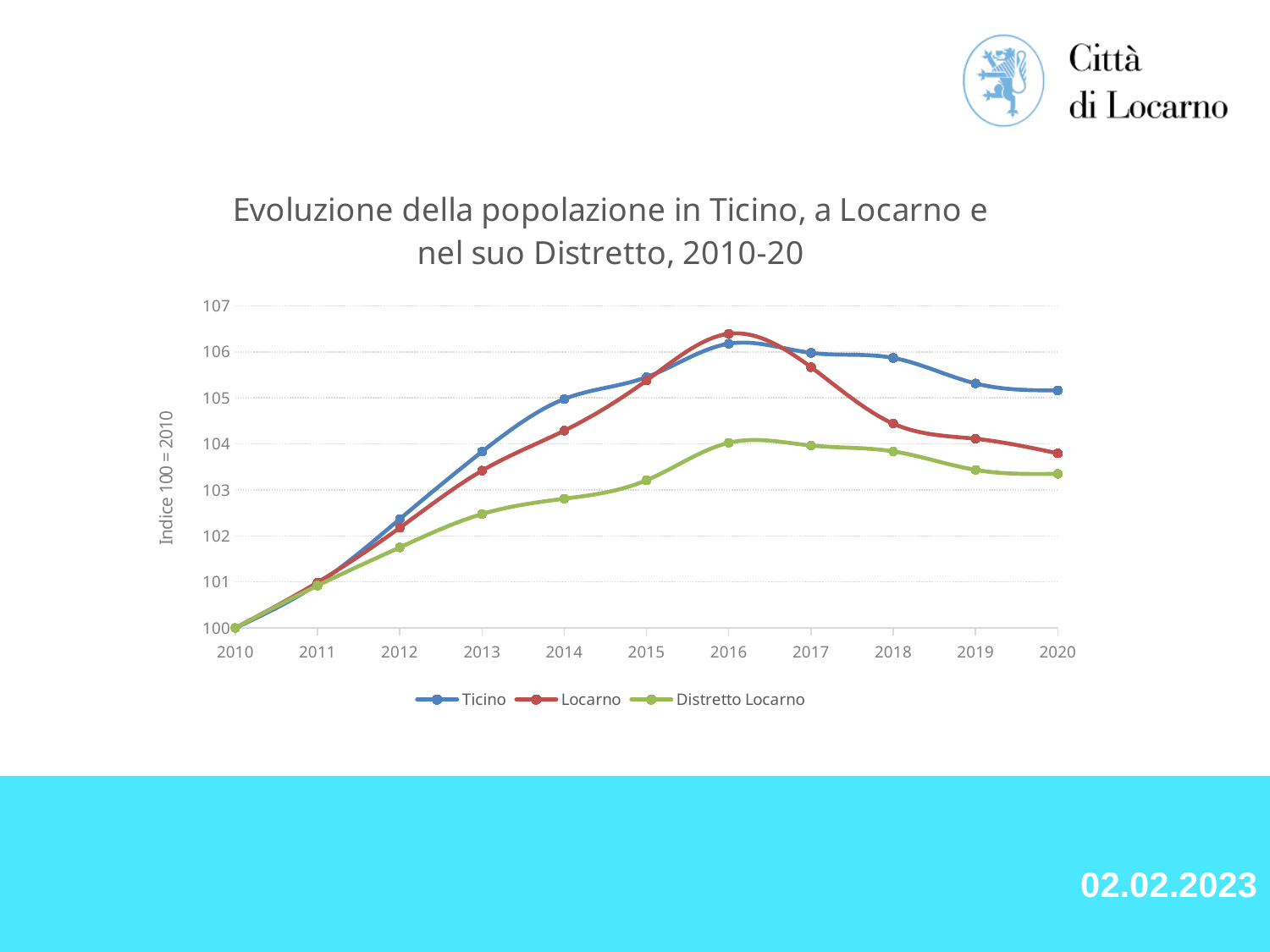
What kind of chart is shown on the slide? line chart Is the value for Ticino in 2014 greater or less than 104? greater Which series has the lowest value in 2016? Distretto Locarno What is the value for Ticino in 2010? 100 How many years are plotted along the x axis? 11 In which year does the Locarno series reach its peak? 2016 Is the value for Locarno in 2016 greater or less than 106? greater Is the value for Distretto Locarno in 2020 greater or less than 104? less How many series does the legend list? 3 Does the Locarno series rise or fall from 2016 to 2020? fall Which series has the highest value in 2018? Ticino In 2020, which is higher: Ticino or Locarno? Ticino